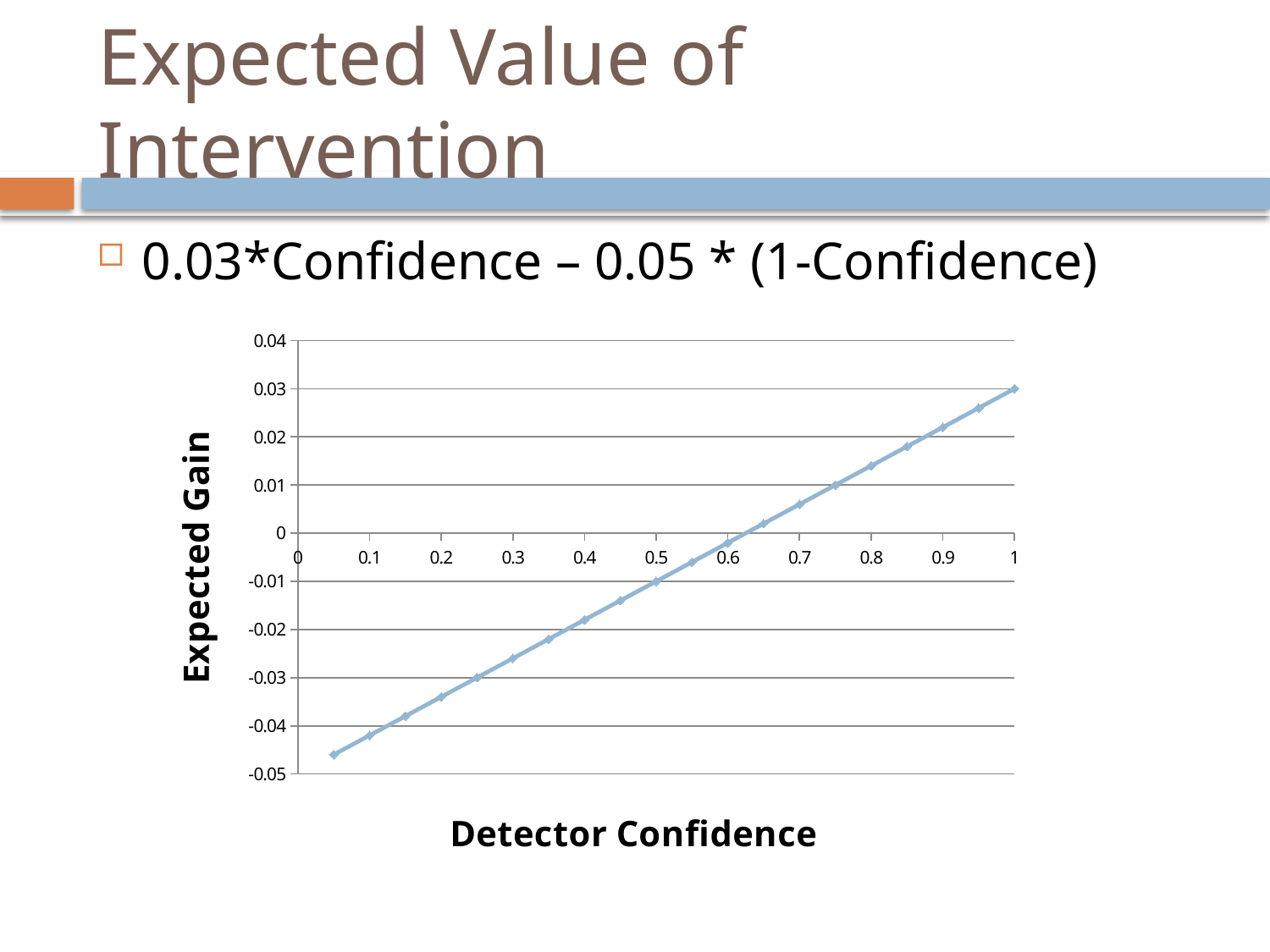
Which detector confidence value gives the highest expected gain? 1 Is the expected gain at detector confidence 0.7 greater or less than 0? greater What is the expected gain when detector confidence is 0.75? 0.01 Is the expected gain at detector confidence 0.8 greater or less than 0.01? greater What is the expected gain when detector confidence is 0.25? -0.03 What is the title of the vertical axis? Expected Gain Does the expected gain rise or fall as detector confidence increases? rises Which is larger, the expected gain at detector confidence 0.8 or at 0.3? 0.8 Is the expected gain at detector confidence 0.2 greater or less than -0.03? less What kind of chart is shown on the slide? line chart What is the expected gain when detector confidence is 1? 0.03 What is the expected gain when detector confidence is 0.5? -0.01